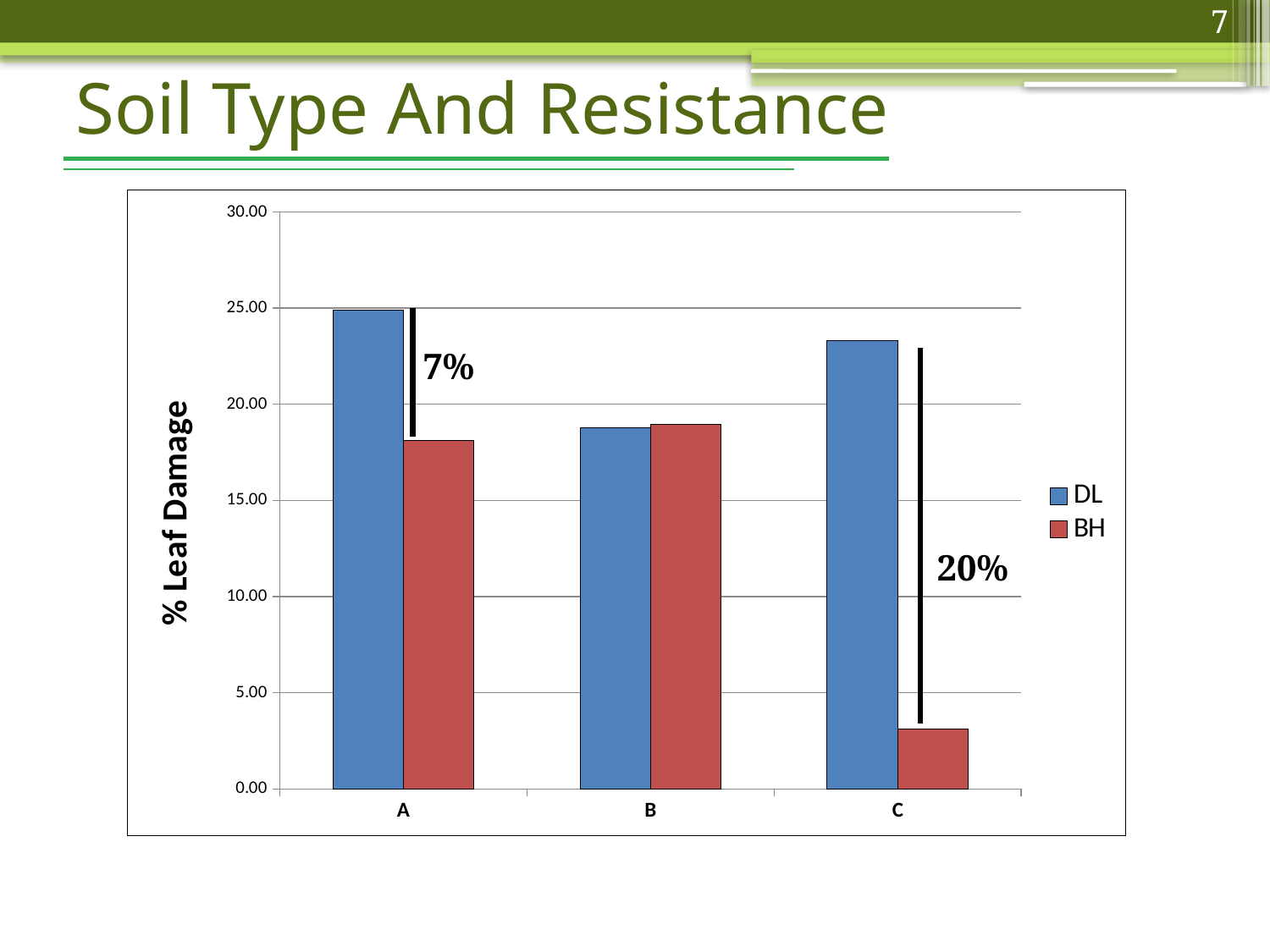
Which series has the lowest bar in the chart? BH at C Which series has the highest bar in the chart? DL at A For soil type C, which series has the larger value, DL or BH? DL For soil type A, which series has the larger value, DL or BH? DL Is the value for BH at soil type B greater or less than 15.00? greater Is the value for BH at soil type C greater or less than 5.00? less Is the value for DL at soil type A greater or less than 20.00? greater What difference between DL and BH is annotated for soil type C? 20% What kind of chart is shown on the slide? bar chart What is the label on the vertical axis? % Leaf Damage How many soil type categories are shown on the x axis? 3 How many series does the legend list? 2